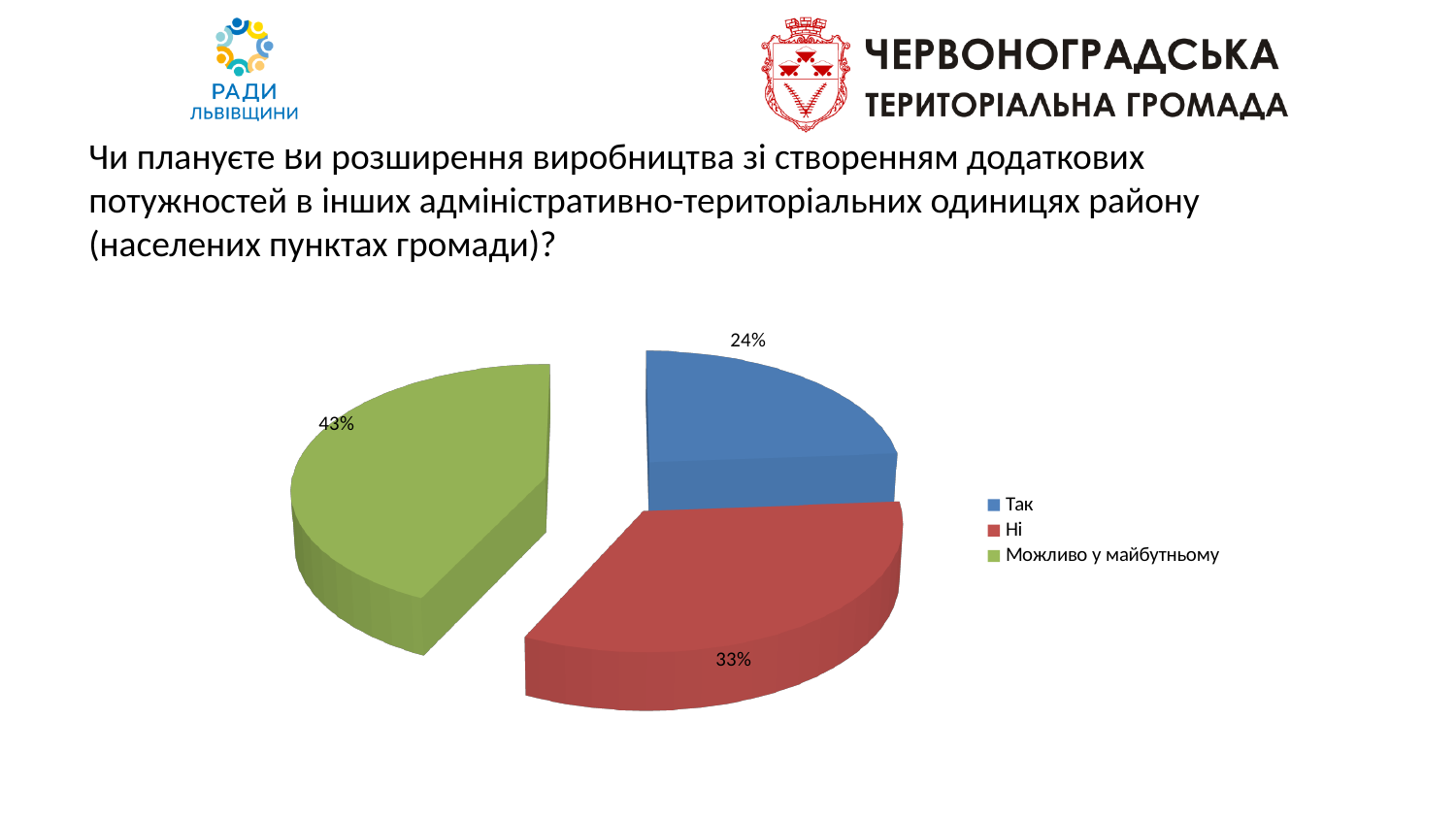
What share of the pie does "Можливо у майбутньому" represent? 43% What share of the pie does "Ні" represent? 33% How many slices does the pie chart have? 3 What share of the pie does "Так" represent? 24% Which category has the largest slice of the pie? Можливо у майбутньому What colour is the slice for "Ні"? Red What is the difference in percentage points between "Ні" and "Так"? 9 What is the difference in percentage points between "Можливо у майбутньому" and "Так"? 19 How many entries does the legend list? 3 Which is larger, the share for "Ні" or the share for "Так"? Ні Which category has the smallest slice of the pie? Так What kind of chart is shown on the slide? Pie chart